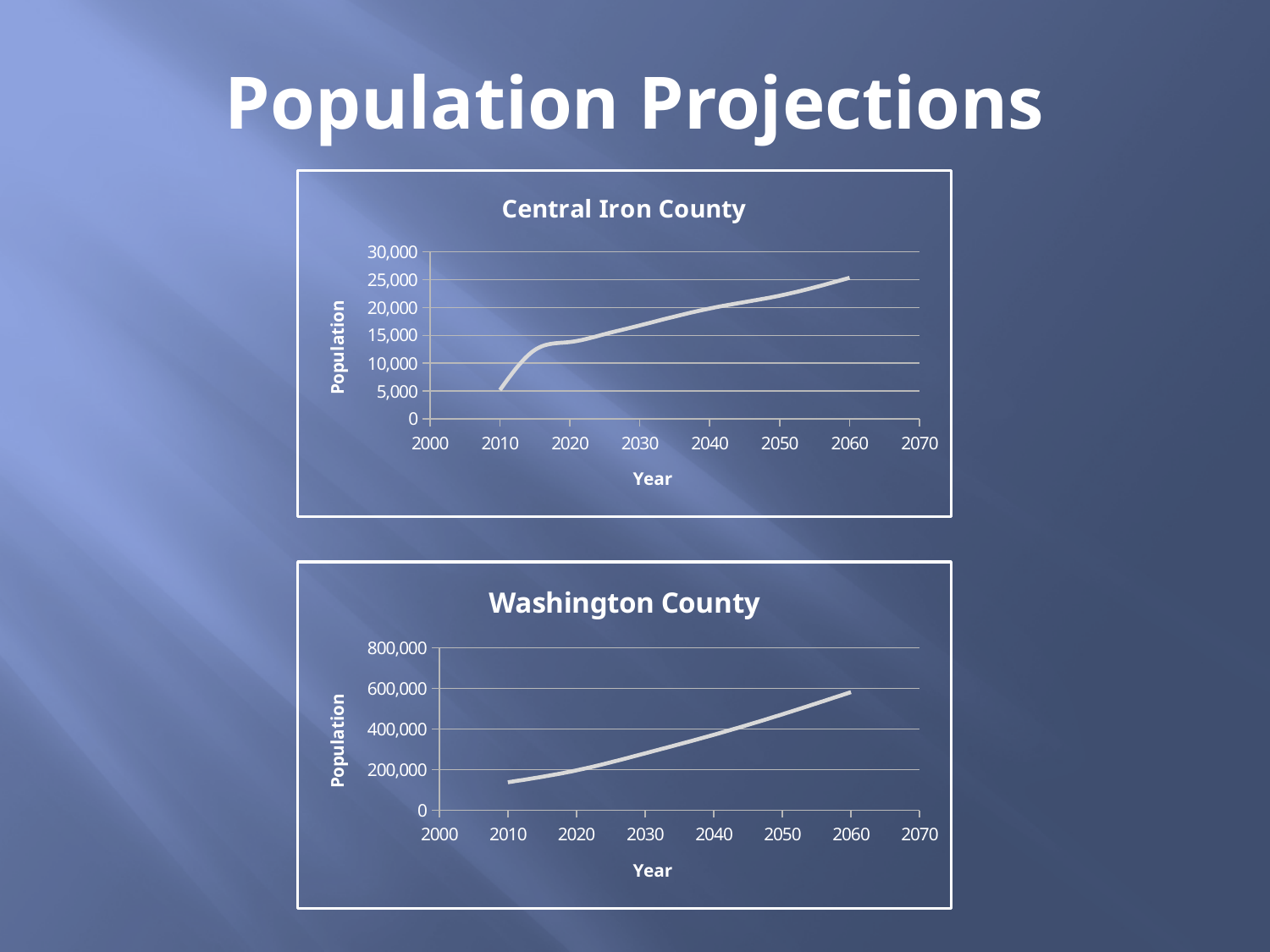
What is the title of the top chart on the slide? Central Iron County In the Washington County chart, is the population value for 2030 greater or less than 200,000? greater In the Washington County chart, is the population value for 2010 greater or less than 200,000? less In the Central Iron County chart, is the population value for 2060 greater or less than 20,000? greater In the Washington County chart, does the population rise or fall from 2010 to 2060? rise What is the label of the x axis on the Washington County chart? Year What kind of chart is the Washington County chart? line chart What kind of chart is the Central Iron County chart? line chart In the Central Iron County chart, does the population rise or fall from 2010 to 2060? rise